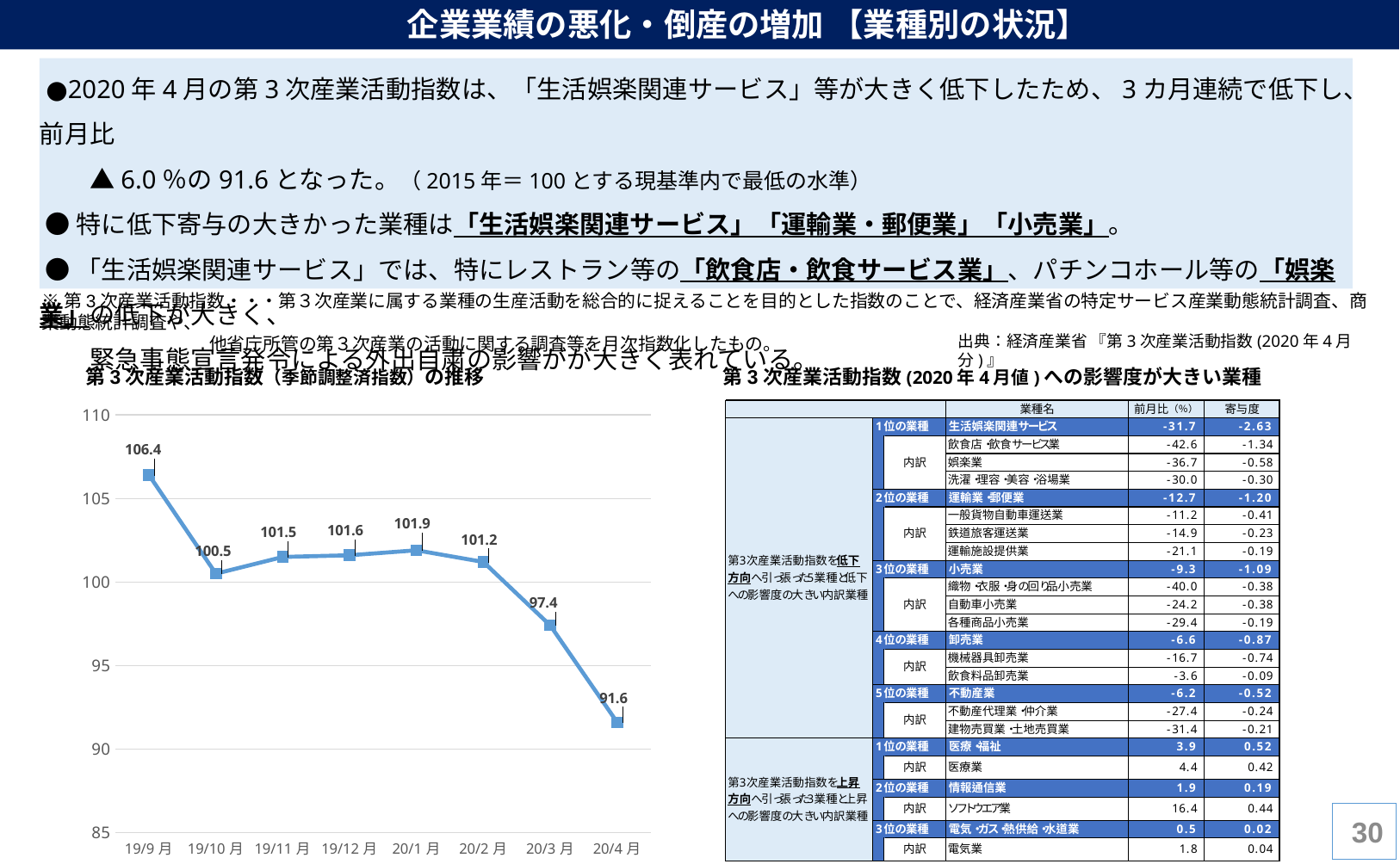
Does the value rise or fall from 20/1月 to 20/4月? fall What is the difference between the values for 20/3月 and 20/4月? 5.8 What is the value of the 第3次産業活動指数 for 20/4月? 91.6 Which month has the highest value in the line chart? 19/9月 What is the value of the 第3次産業活動指数 for 20/1月? 101.9 What is the value of the 第3次産業活動指数 for 19/9月? 106.4 How many data points are plotted in the line chart? 8 Which month has the lowest value in the line chart? 20/4月 What is the title of the line chart? 第3次産業活動指数（季節調整済指数）の推移 What is the value of the 第3次産業活動指数 for 20/3月? 97.4 Which is larger, the value for 19/10月 or the value for 19/11月? 19/11月 What type of chart is shown on the slide? line chart